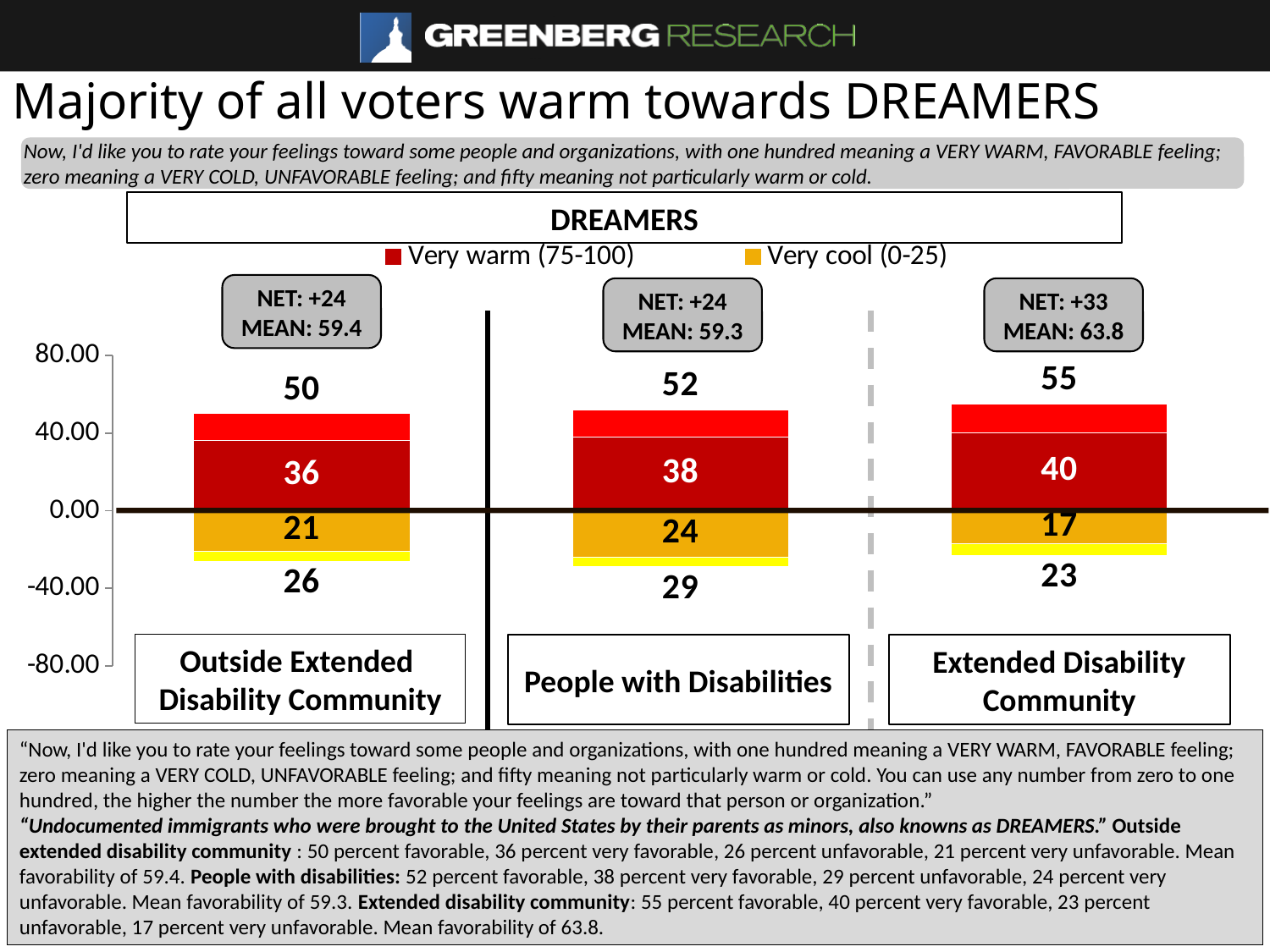
Which group has the highest 'Very warm (75-100)' value? Extended Disability Community What is the NET value shown for People with Disabilities? +24 What is the total favorable percentage shown for Outside Extended Disability Community? 50 What is the 'Very cool (0-25)' value for the Extended Disability Community? 17 What is the MEAN value shown for the Extended Disability Community? 63.8 Which group has the lowest 'Very cool (0-25)' value? Extended Disability Community How many groups are shown on the x axis of the chart? 3 What is the difference between the 'Very warm (75-100)' values for Extended Disability Community and Outside Extended Disability Community? 4 How many series does the chart legend list? 2 What kind of chart is shown on the slide? Bar chart What is the 'Very warm (75-100)' value for People with Disabilities? 38 Which is larger: the 'Very cool (0-25)' value for People with Disabilities or for Outside Extended Disability Community? People with Disabilities